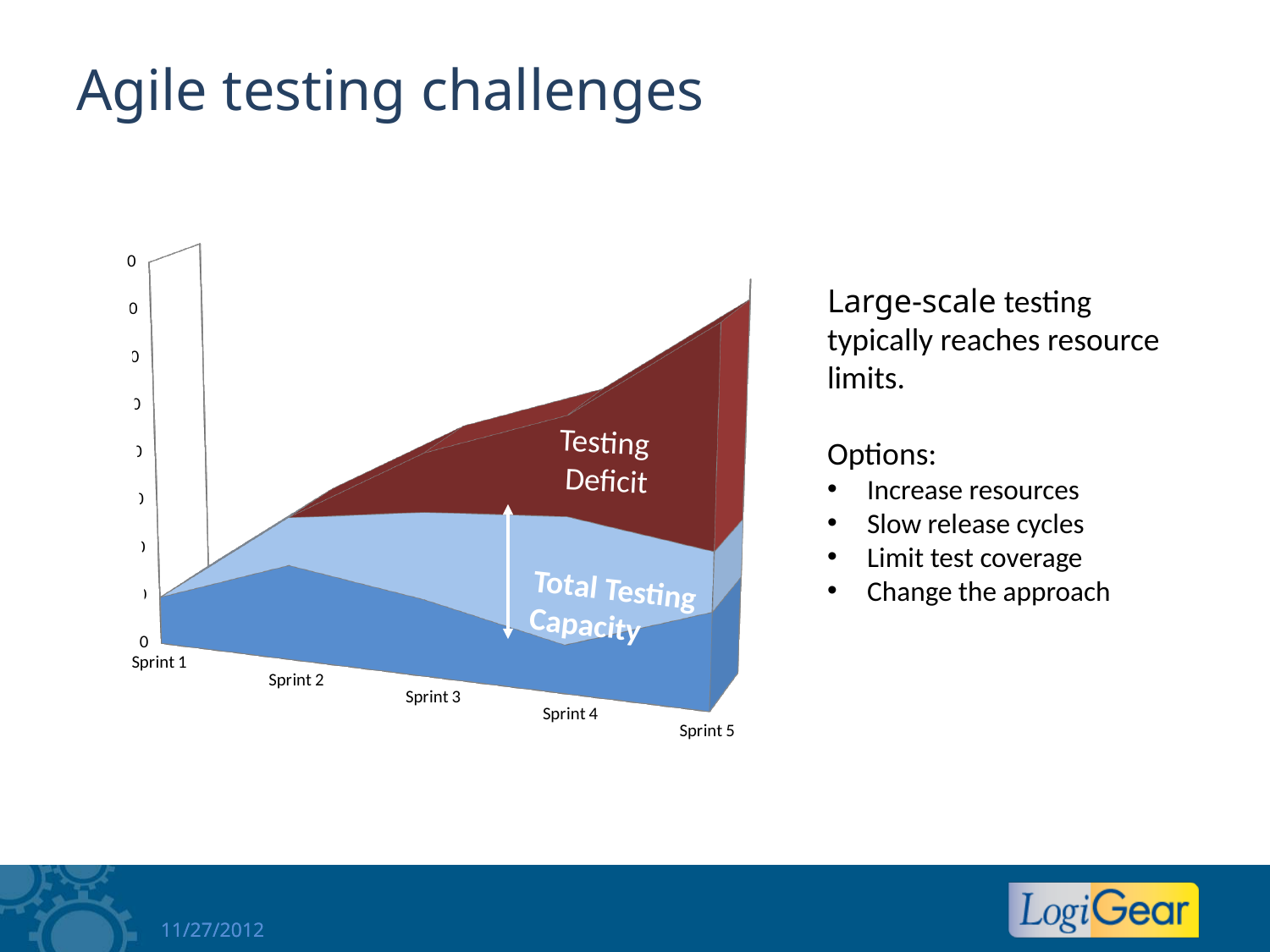
Which sprint has the smallest total stacked height in the chart? Sprint 1 Which has the larger total stacked height, Sprint 2 or Sprint 4? Sprint 4 Does the total stacked height of the chart rise or fall from Sprint 1 to Sprint 5? Rise What is the label of the last category on the x axis? Sprint 5 Which has the larger total stacked height, Sprint 1 or Sprint 5? Sprint 5 Does the dark red 'Testing Deficit' area grow or shrink from Sprint 2 to Sprint 5? Grow What is the label of the first category on the x axis? Sprint 1 What kind of chart is shown on the slide? Area chart How many sprints are shown along the x axis of the chart? 5 Which sprint has the greatest total stacked height in the chart? Sprint 5